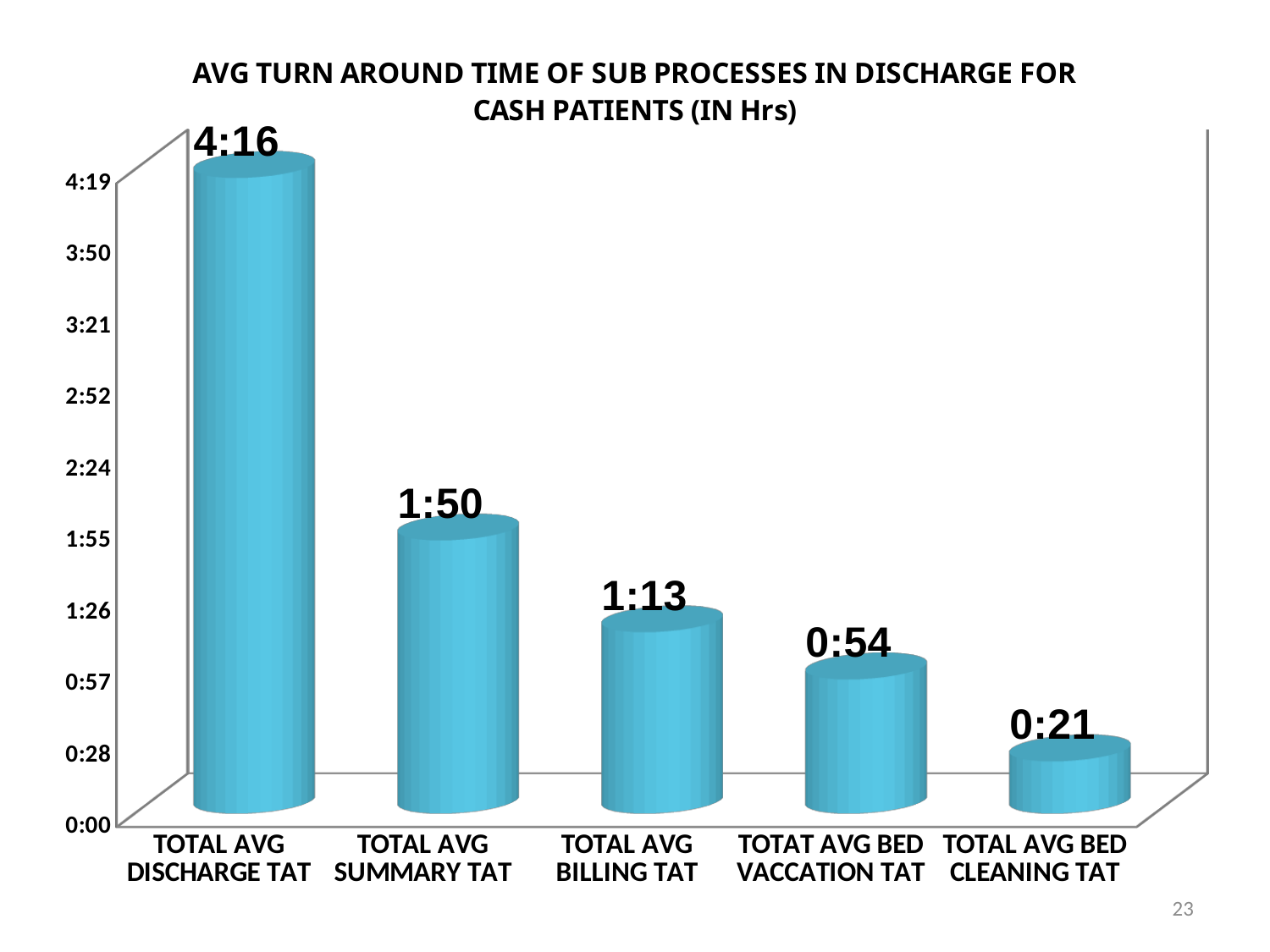
What is the value for TOTAL AVG SUMMARY TAT? 1:50 Which category has the highest value? TOTAL AVG DISCHARGE TAT Which is larger, TOTAL AVG SUMMARY TAT or TOTAL AVG BILLING TAT? TOTAL AVG SUMMARY TAT What is the difference between TOTAL AVG DISCHARGE TAT and TOTAL AVG SUMMARY TAT? 2:26 What is the value for TOTAL AVG BED CLEANING TAT? 0:21 What is the value for TOTAL AVG DISCHARGE TAT? 4:16 What is the difference between TOTAL AVG BILLING TAT and TOTAT AVG BED VACCATION TAT? 0:19 What is the value for TOTAL AVG BILLING TAT? 1:13 What kind of chart is this? Bar chart How many categories are shown in the chart? 5 Do the values rise or fall from left to right across the categories? Fall Which category has the lowest value? TOTAL AVG BED CLEANING TAT